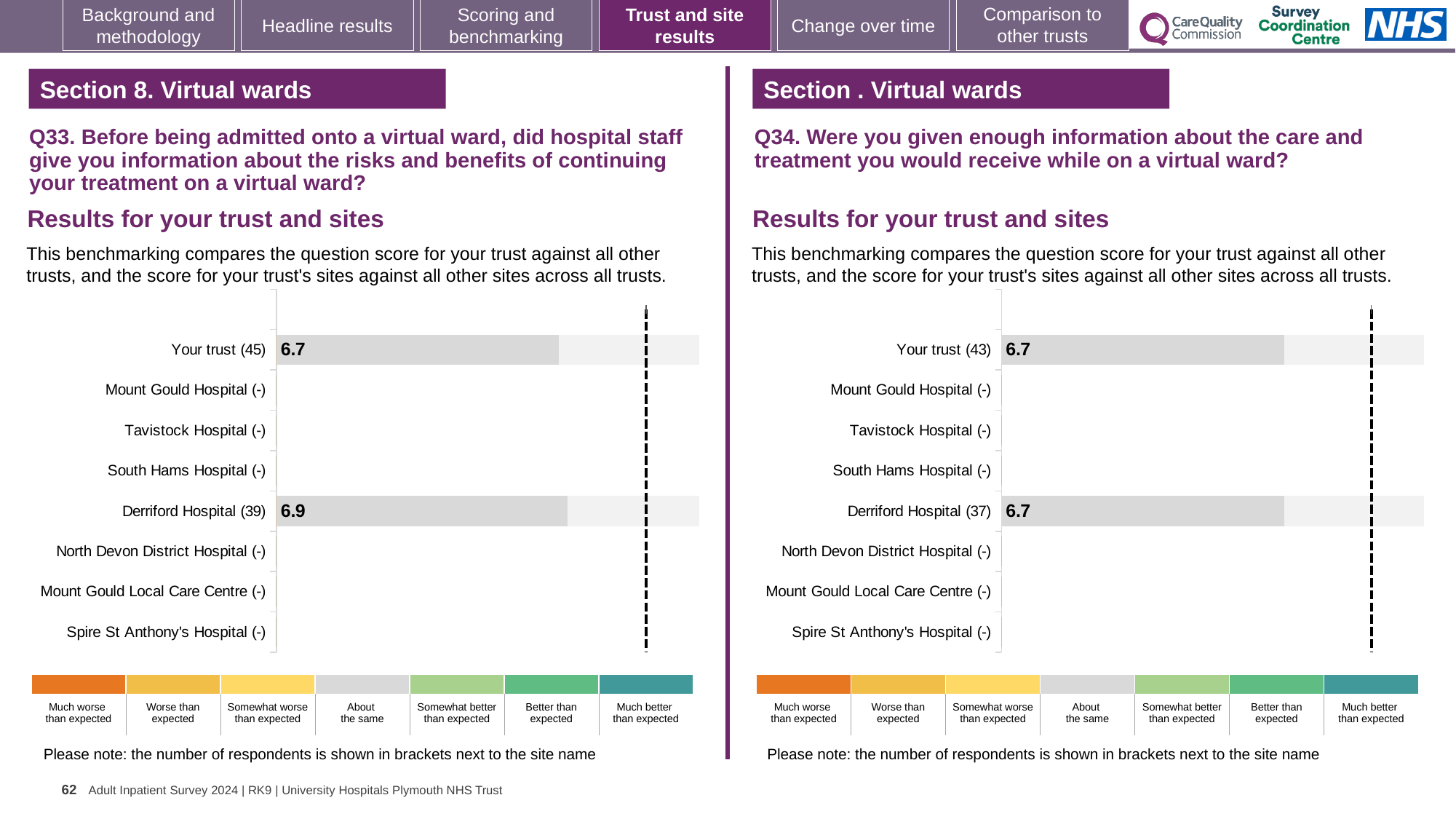
In the Q34 chart on the right, what is the score for Derriford Hospital? 6.7 In the Q33 chart on the left, what is the score for Your trust? 6.7 How many site categories are listed on the y axis of the Q33 chart on the left? 8 In the Q34 chart on the right, what is the difference between the Your trust score and the Derriford Hospital score? 0 How many benchmark categories are shown in the colour key below the Q33 chart on the left? 7 In the Q33 chart on the left, what is the difference between the Derriford Hospital score and the Your trust score? 0.2 In the Q34 chart on the right, how many respondents are shown in brackets for Your trust? 43 In the Q33 chart on the left, how many respondents are shown in brackets for Derriford Hospital? 39 In the Q33 chart on the left, what is the score for Derriford Hospital? 6.9 What type of chart is used for the Q34 results on the right? Bar chart In the Q34 chart on the right, what is the score for Your trust? 6.7 In the Q33 chart on the left, which is higher: the score for Your trust or for Derriford Hospital? Derriford Hospital